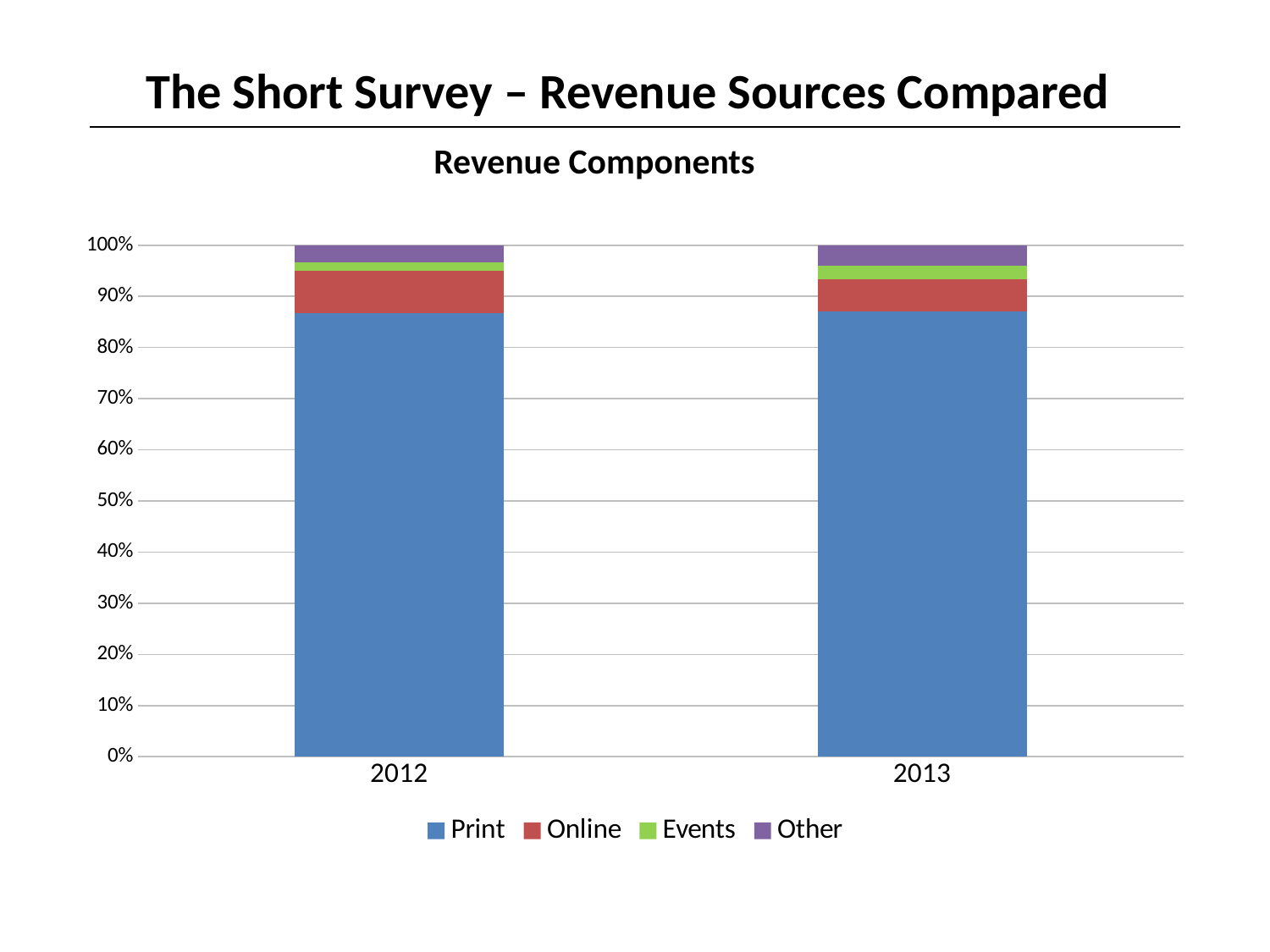
Is the Print share in 2013 greater or less than 90%? less What is the title of the chart? Revenue Components Which series is shown in blue in the legend? Print How many years are shown on the x axis? 2 Which revenue source makes up the largest share of the 2012 bar? Print What kind of chart is shown on the slide? Stacked bar chart In 2012, which is larger, the Print share or the Online share? Print Is the Print share in 2012 greater or less than 80%? greater What is the total height of the stacked bar for 2013? 100% How many series does the legend list? 4 Is the Events share larger in 2012 or in 2013? 2013 Which revenue source makes up the largest share of the 2013 bar? Print